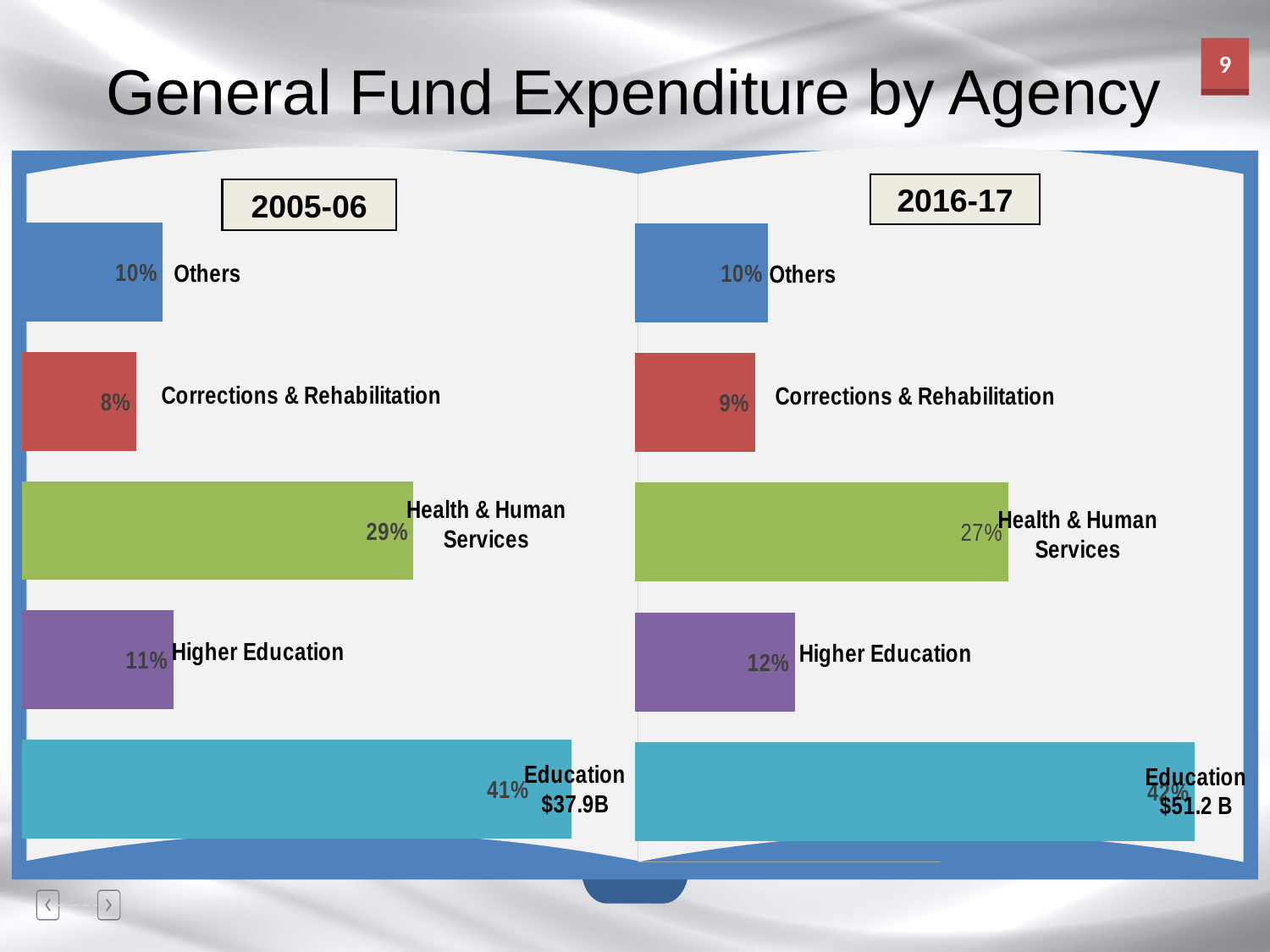
In the 2016-17 chart, which is larger: the share for Higher Education or the share for Others? Higher Education In the 2005-06 chart, which agency has the largest share? Education In the 2005-06 chart, what percentage is shown for Health & Human Services? 29% What type of chart is used for the 2005-06 data? Bar chart In the 2005-06 chart, what percentage is shown for Higher Education? 11% In the 2005-06 chart, what dollar amount is shown for Education? $37.9B In the 2005-06 chart, what is the difference between the Education share and the Health & Human Services share? 12% In the 2016-17 chart, what percentage is shown for Corrections & Rehabilitation? 9% In the 2016-17 chart, which agency has the smallest share? Corrections & Rehabilitation How many agency categories are shown in the 2016-17 chart? 5 What is the title of the slide containing the two charts? General Fund Expenditure by Agency In the 2016-17 chart, what dollar amount is shown for Education? $51.2 B